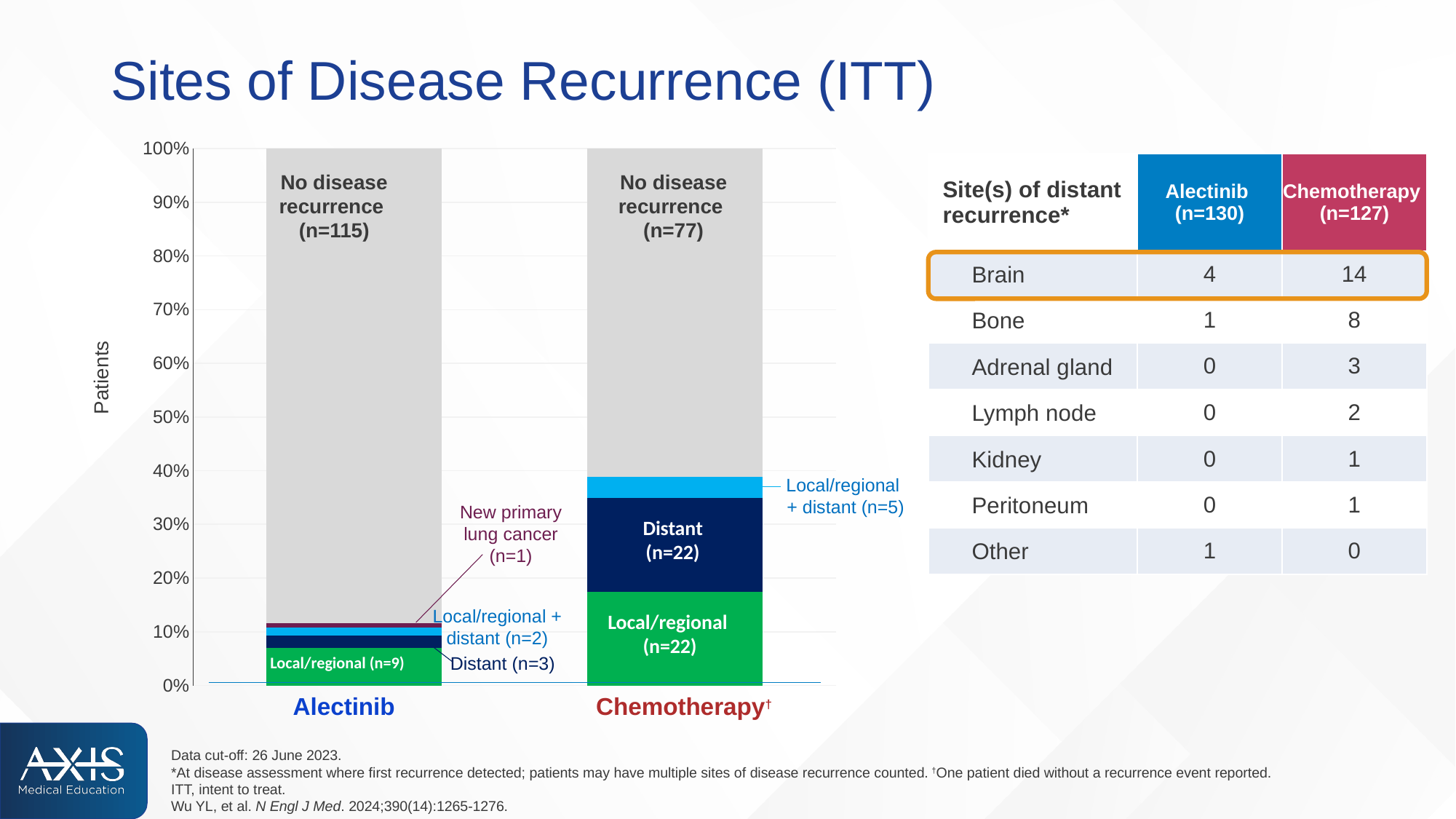
How many more patients had Distant recurrence in the Chemotherapy arm than in the Alectinib arm? 19 How many Chemotherapy patients had Local/regional + distant recurrence? n=5 How many Chemotherapy patients had no disease recurrence according to the chart? n=77 How many treatment arms (bars) are plotted in the chart? 2 What is the number of patients in the Local/regional segment of the Alectinib bar? n=9 How many Alectinib patients had a new primary lung cancer? n=1 Is the proportion of Chemotherapy patients with no disease recurrence greater or less than 50%? greater What is the total number of patients represented by all segments of the Alectinib bar? 130 How many Alectinib patients had no disease recurrence according to the chart? n=115 Which arm had more patients with no disease recurrence, Alectinib or Chemotherapy? Alectinib What is the number of patients in the Distant segment of the Chemotherapy bar? n=22 What kind of chart is shown on the slide? Stacked bar chart